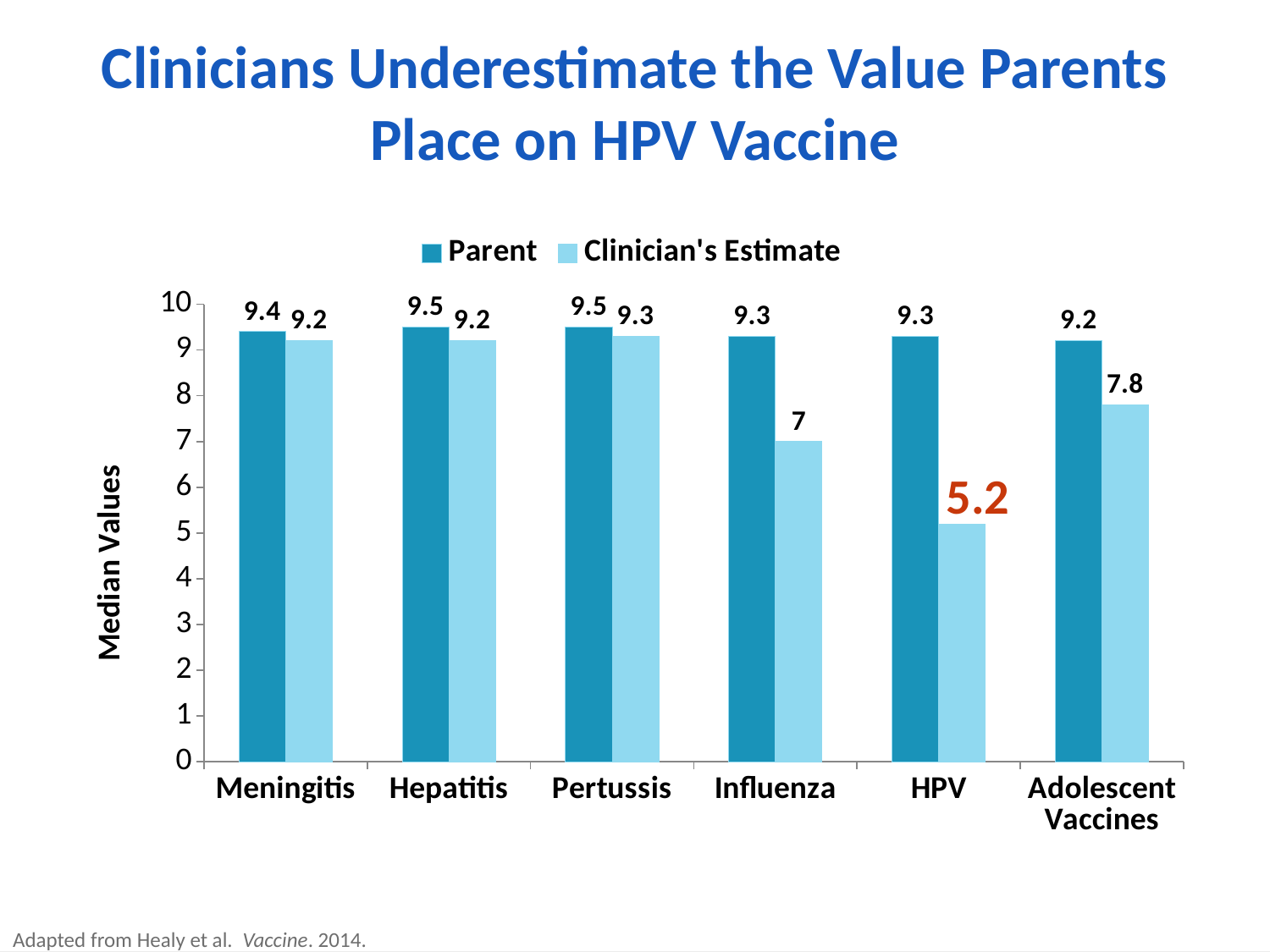
What is the label of the y axis? Median Values How many categories are shown on the x axis? 6 What is the difference between the Parent value and the Clinician's Estimate value for Influenza? 2.3 What is the difference between the Parent value and the Clinician's Estimate value for HPV? 4.1 Which category has the lowest Clinician's Estimate value? HPV What kind of chart is shown on the slide? Bar chart Which is larger for Adolescent Vaccines, the Parent value or the Clinician's Estimate value? Parent What is the Parent value for Hepatitis? 9.5 How many series does the legend list? 2 What is the Clinician's Estimate value for Adolescent Vaccines? 7.8 What is the Parent value for Influenza? 9.3 What is the Clinician's Estimate value for HPV? 5.2